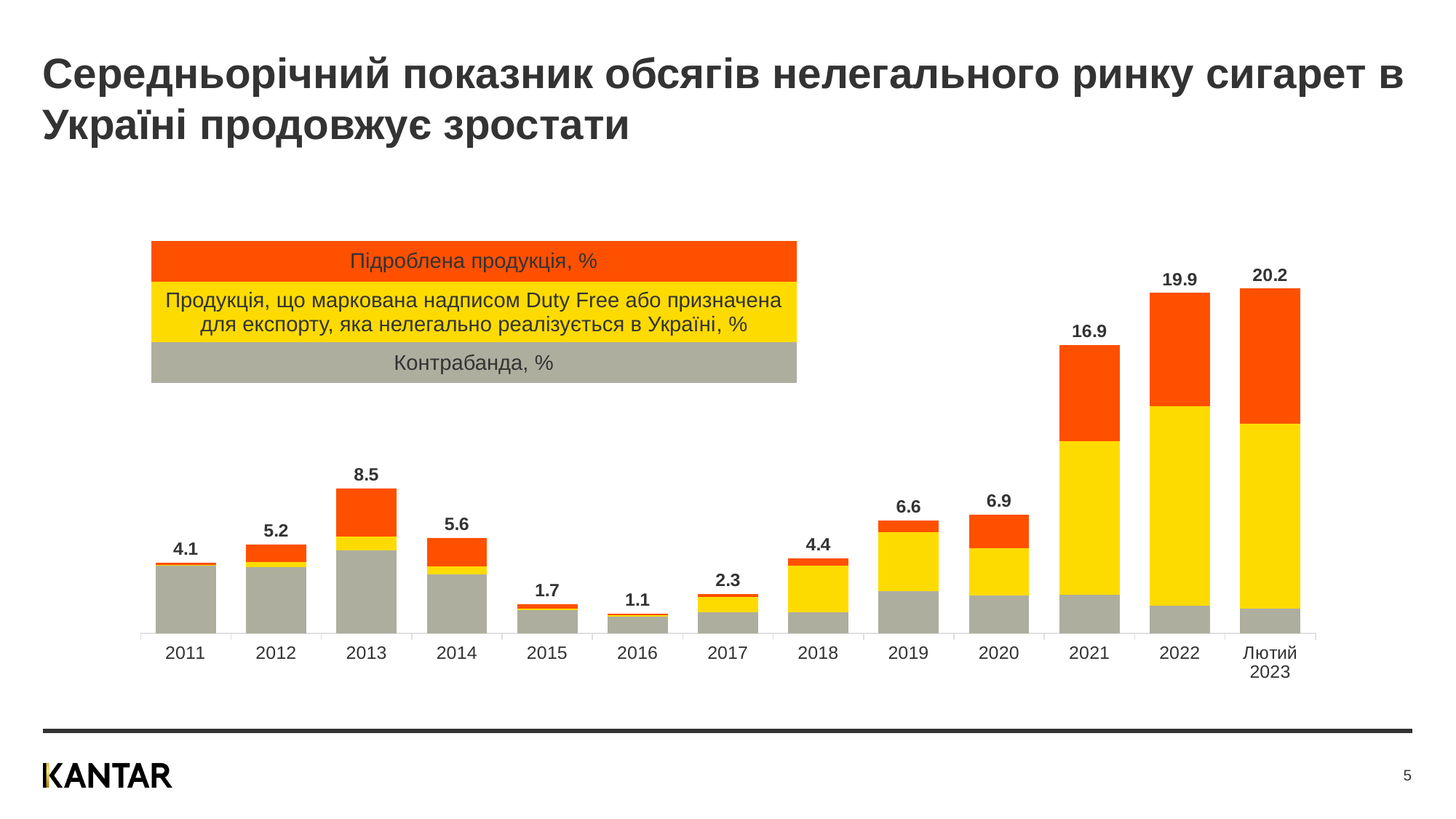
How many series does the legend list? 3 What is the difference between the total values for 2022 and 2021? 3.0 What is the total value shown for 2016? 1.1 Which year has the highest total value on the chart? Лютий 2023 What is the difference between the total values for 2013 and 2014? 2.9 What is the total illegal cigarette market share shown for 2013? 8.5 What kind of chart is shown on the slide? Stacked bar chart How many time periods (bars) are shown on the x axis? 13 What is the total value shown for Лютий 2023? 20.2 Which year has the lowest total value on the chart? 2016 Which has a larger total value, 2019 or 2020? 2020 Which colour represents Контрабанда, % in the chart? Grey